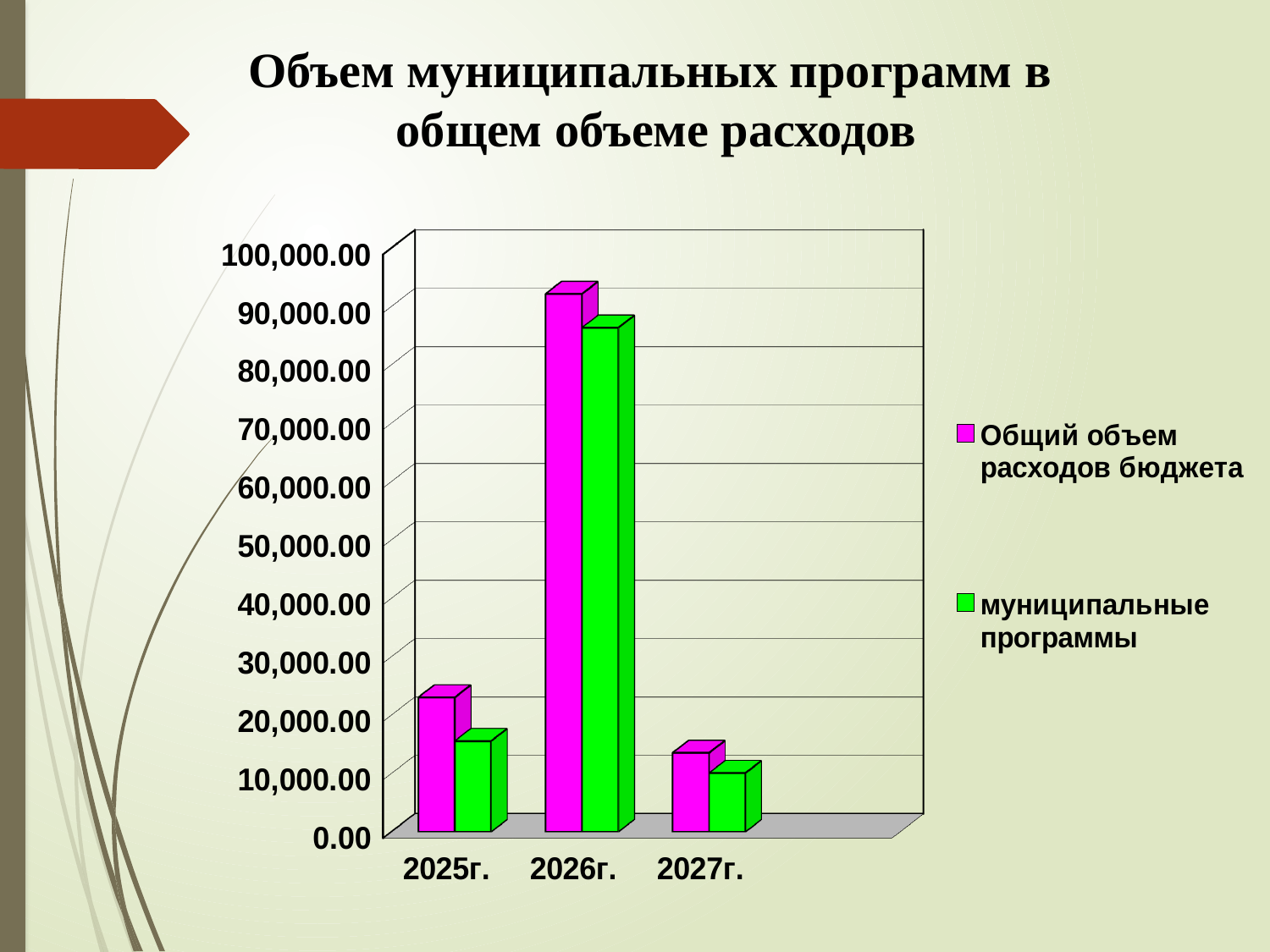
Does the value for Общий объем расходов бюджета rise or fall from 2026г. to 2027г.? fall How many series does the legend list? 2 Is the value for муниципальные программы in 2027г. greater or less than 20,000.00? less Is the value for муниципальные программы in 2026г. greater or less than 80,000.00? greater In 2026г., which is larger: Общий объем расходов бюджета or муниципальные программы? Общий объем расходов бюджета Is the value for Общий объем расходов бюджета in 2026г. greater or less than 80,000.00? greater What colour represents муниципальные программы in the legend? green What kind of chart is shown on the slide? bar chart Which year has the lowest value for муниципальные программы? 2027г. How many year categories are shown on the x axis? 3 Which year has the highest value for Общий объем расходов бюджета? 2026г.